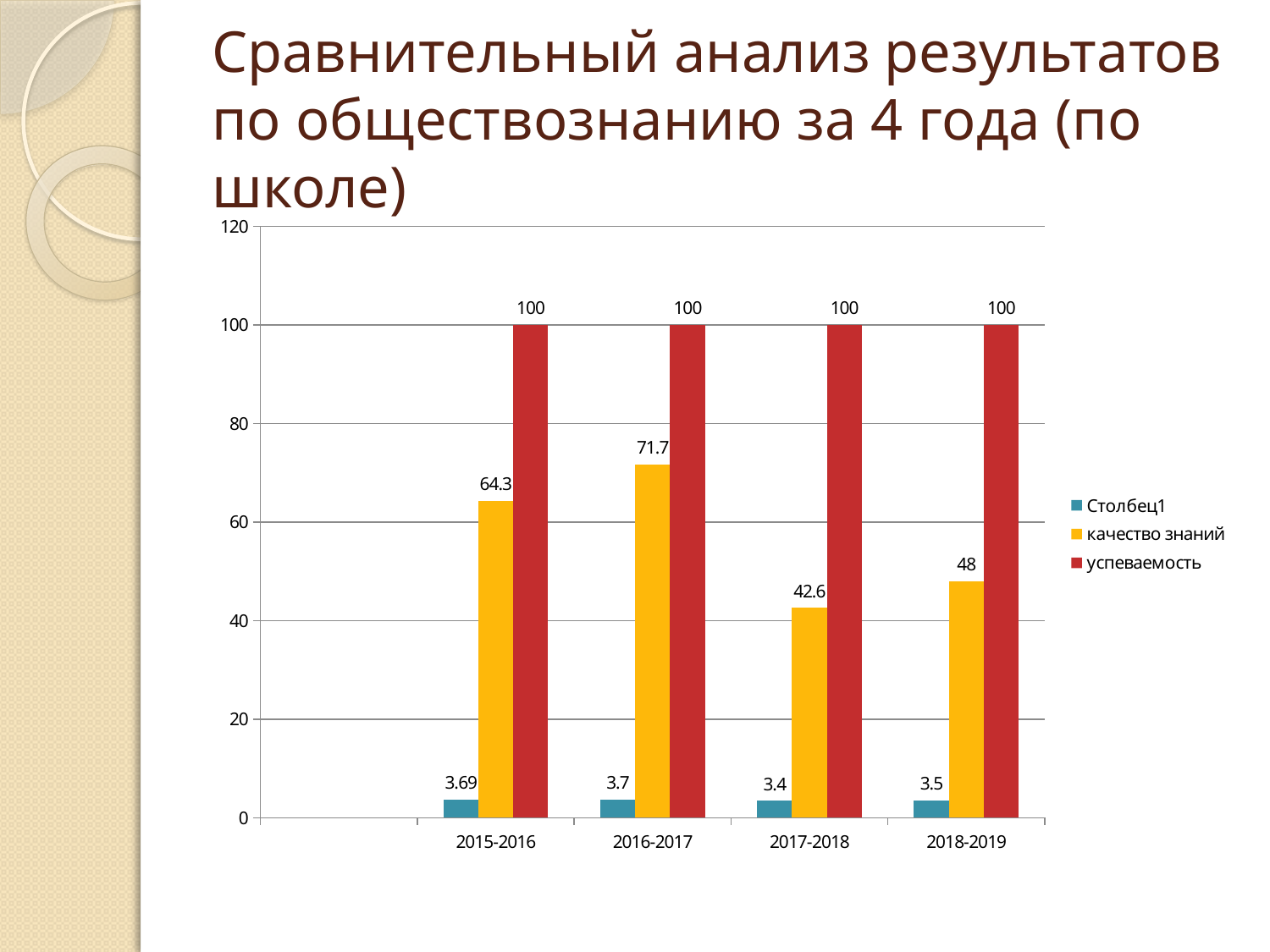
What is the value of "качество знаний" for 2017-2018? 42.6 Which year has the highest value for "качество знаний"? 2016-2017 What is the value of "качество знаний" for 2016-2017? 71.7 What kind of chart is shown on the slide? bar chart How many series does the legend list? 3 What is the value of "успеваемость" for 2018-2019? 100 Which series is shown in red in the legend? успеваемость What is the value of "Столбец1" for 2015-2016? 3.69 Which year has the lowest value for "качество знаний"? 2017-2018 Which is larger: the "качество знаний" value for 2015-2016 or for 2018-2019? 2015-2016 What is the difference between the "качество знаний" values for 2016-2017 and 2017-2018? 29.1 How many year categories are shown on the x axis? 4